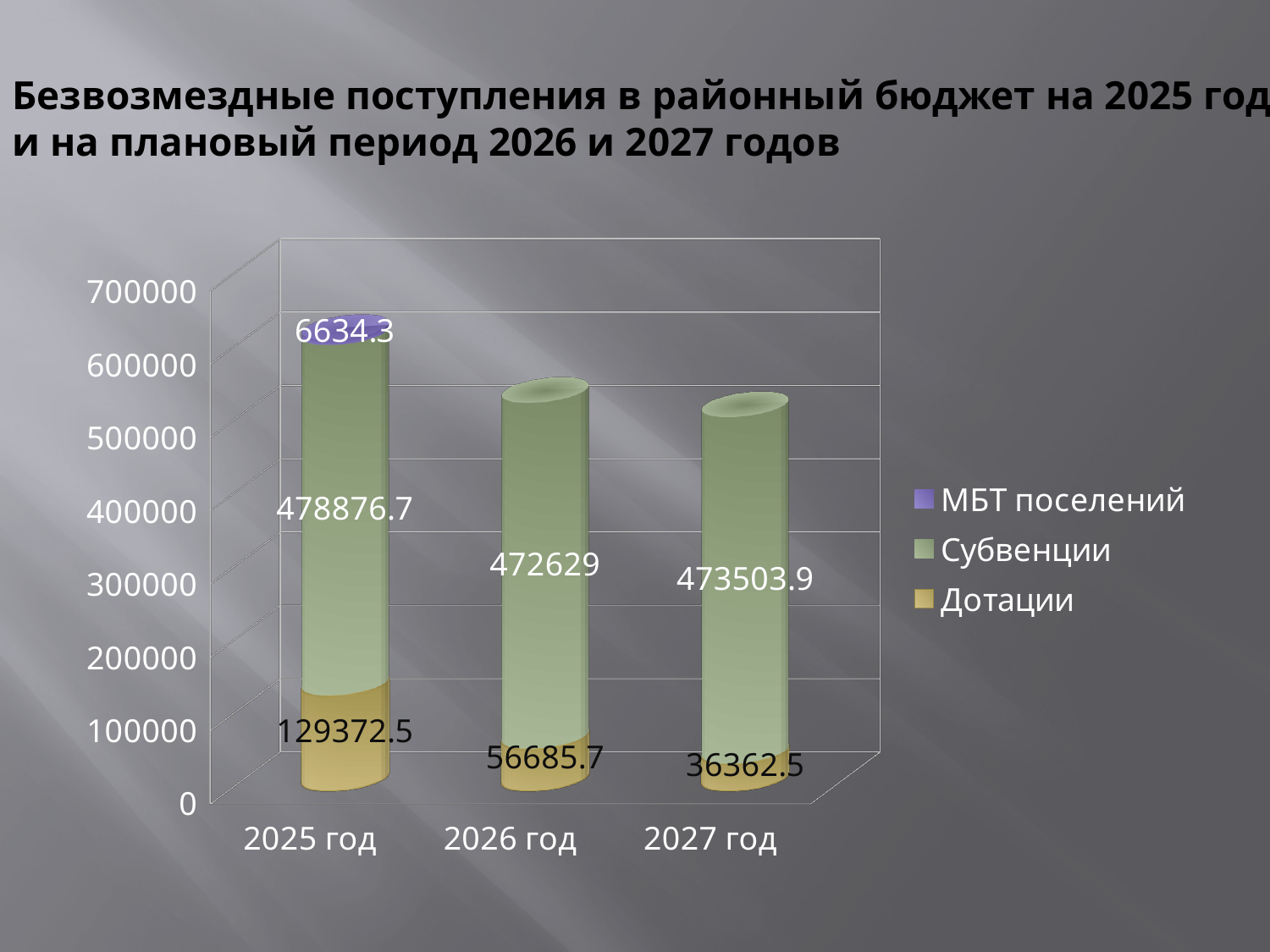
What is the difference between Дотации in 2025 год and 2026 год? 72686.8 What is the value of Субвенции for 2026 год? 472629 Which year has the highest value for Дотации? 2025 год Which year has the lowest value for Дотации? 2027 год How many years are shown on the x axis? 3 Which is larger: Субвенции in 2025 год or Субвенции in 2027 год? 2025 год What is the value of Дотации for 2025 год? 129372.5 What is the total of the stacked bar for 2026 год? 529314.7 Do the values for Дотации rise or fall from 2025 год to 2027 год? fall How many series does the legend list? 3 What is the value of Дотации for 2027 год? 36362.5 What is the value of МБТ поселений for 2025 год? 6634.3